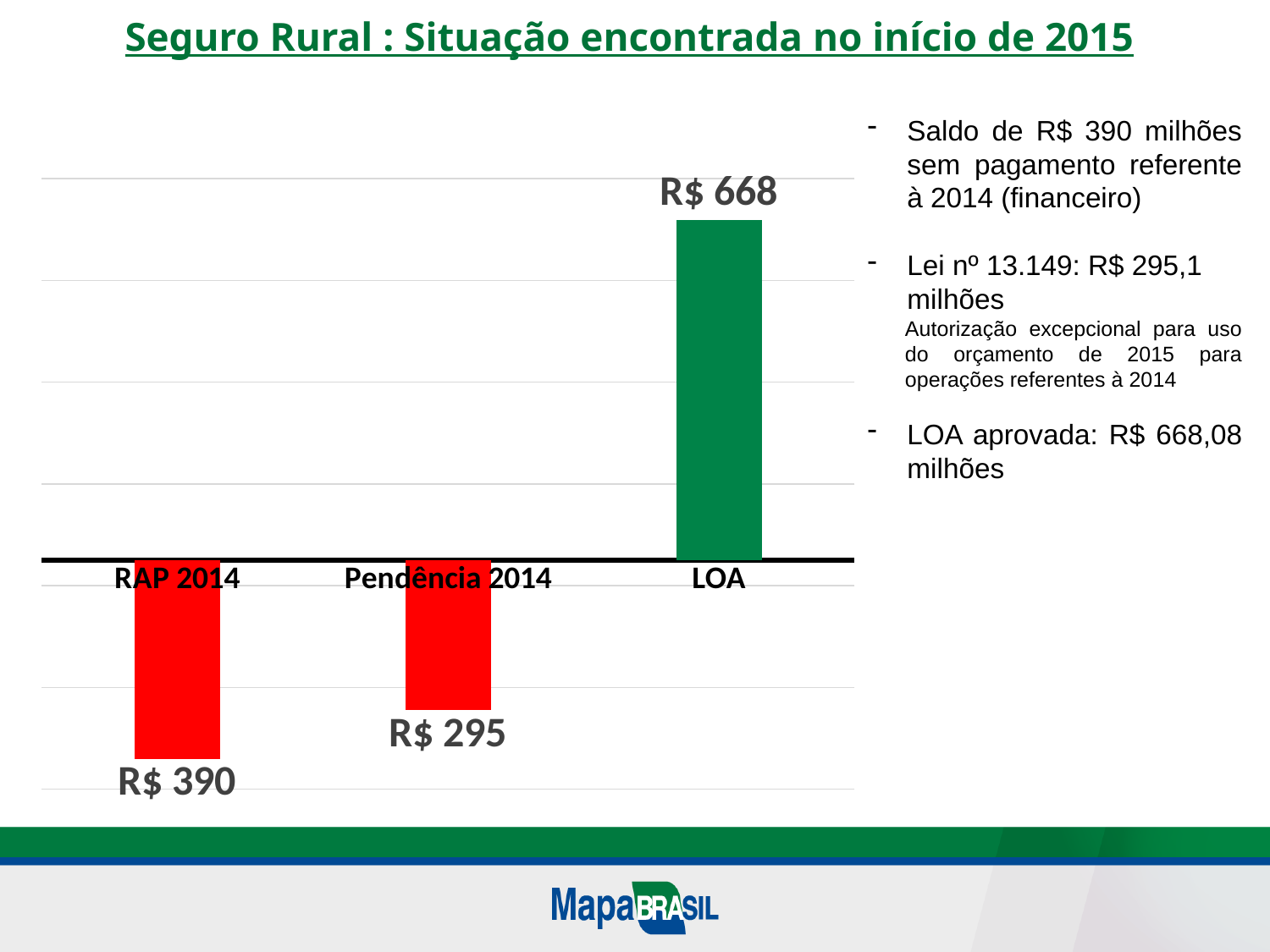
How many categories are shown in the chart? 3 What value is labelled on the Pendência 2014 bar? R$ 295 Which has the larger labelled amount, RAP 2014 or Pendência 2014? RAP 2014 What colour is the LOA bar? Green What is the difference between the labelled values of RAP 2014 and Pendência 2014? R$ 95 Which category's bar extends furthest below the baseline? RAP 2014 What is the difference between the labelled values of LOA and RAP 2014? R$ 278 What value is labelled on the RAP 2014 bar? R$ 390 Which category has the highest bar, extending above the baseline? LOA Which bars are coloured red? RAP 2014 and Pendência 2014 What value is labelled on the LOA bar? R$ 668 What kind of chart is shown on the slide? Bar chart